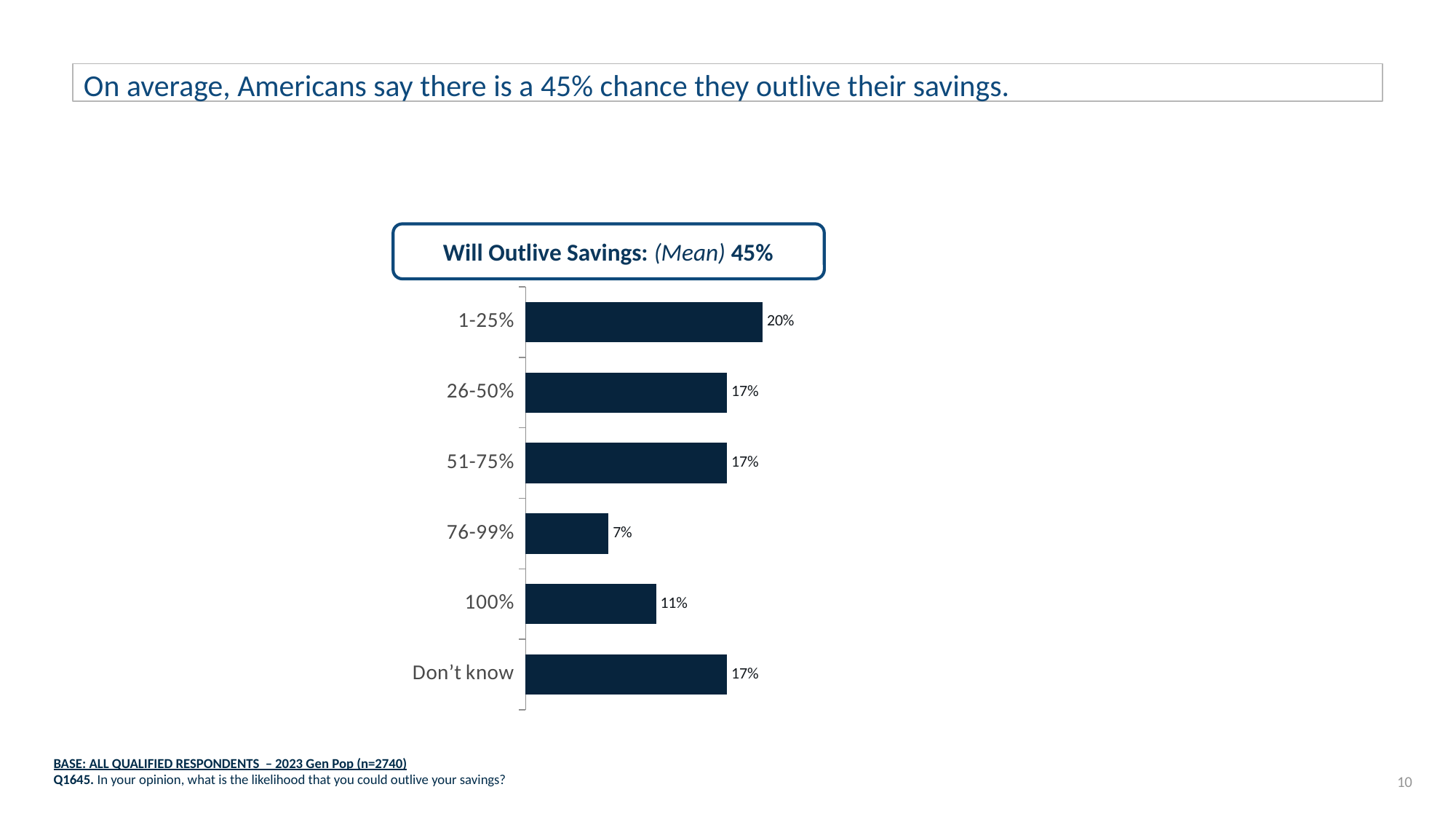
What is the difference between the values for 1-25% and 76-99%? 13% What is the difference between the values for 100% and 76-99%? 4% How many categories are shown in the chart? 6 Which category has the highest value? 1-25% What percentage of respondents said there is a 1-25% chance they could outlive their savings? 20% Which is larger, the value for 26-50% or the value for 100%? 26-50% What percentage of respondents answered 100%? 11% What kind of chart is shown on the slide? Bar chart What mean value is shown in the chart's title box? 45% What is the value for the 76-99% category? 7% Which category has the lowest value? 76-99% What is the value for the Don't know category? 17%